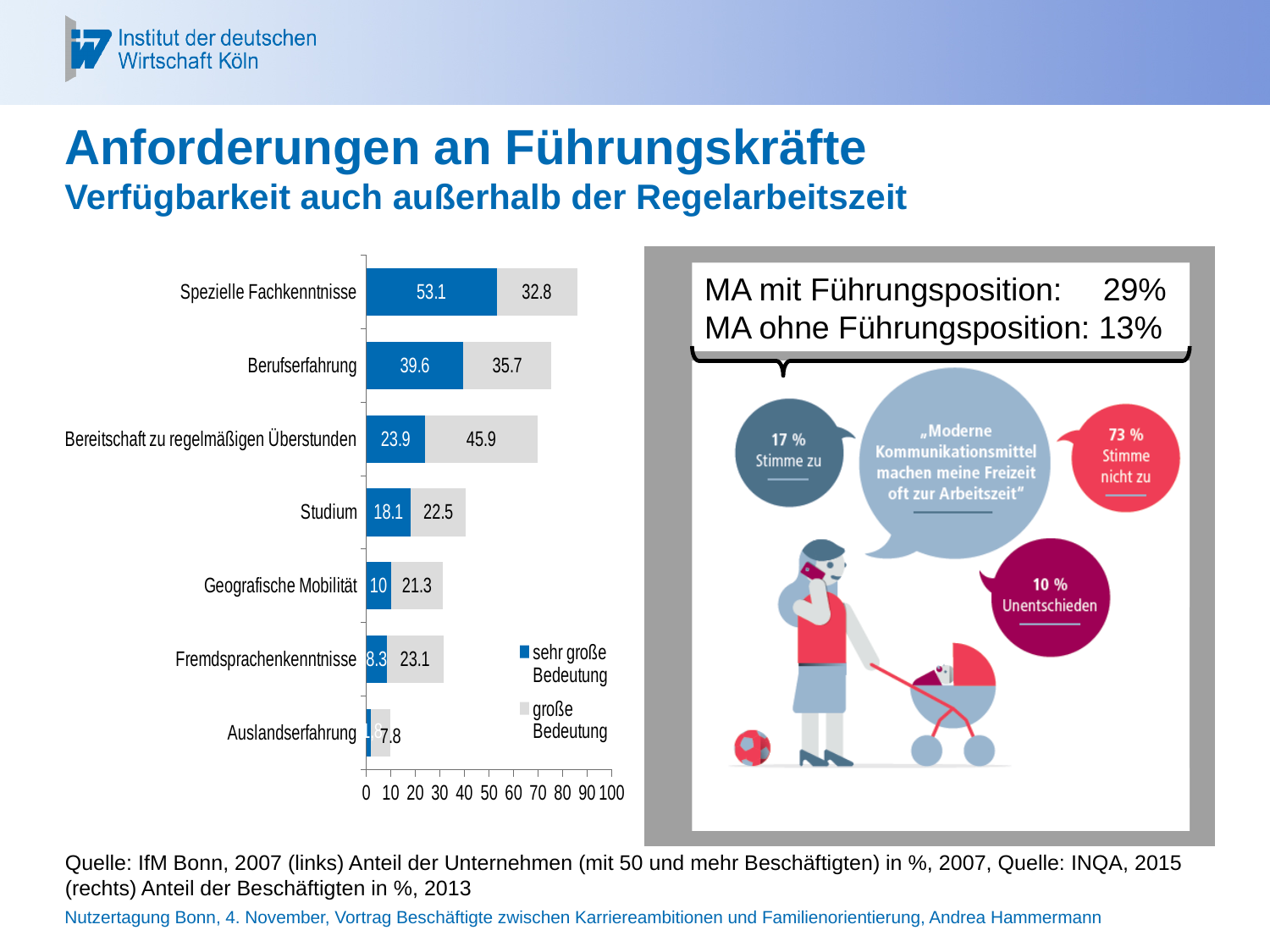
In the bar chart on the left, which has the larger "sehr große Bedeutung" value: Studium or Geografische Mobilität? Studium What kind of chart is shown on the left of the slide? Bar chart In the bar chart on the left, what is the value for "große Bedeutung" for Bereitschaft zu regelmäßigen Überstunden? 45.9 In the bar chart on the left, what is the difference between the "sehr große Bedeutung" and "große Bedeutung" values for Berufserfahrung? 3.9 In the bar chart on the left, what is the value for "große Bedeutung" for Auslandserfahrung? 7.8 In the bar chart on the left, which colour represents "sehr große Bedeutung"? Blue In the bar chart on the left, which category has the highest value for "sehr große Bedeutung"? Spezielle Fachkenntnisse In the bar chart on the left, what is the total of the stacked bar for Spezielle Fachkenntnisse? 85.9 How many series does the legend of the bar chart on the left list? 2 In the bar chart on the left, which category has the lowest value for "große Bedeutung"? Auslandserfahrung In the bar chart on the left, what is the value for "sehr große Bedeutung" for Spezielle Fachkenntnisse? 53.1 How many categories are shown in the bar chart on the left? 7